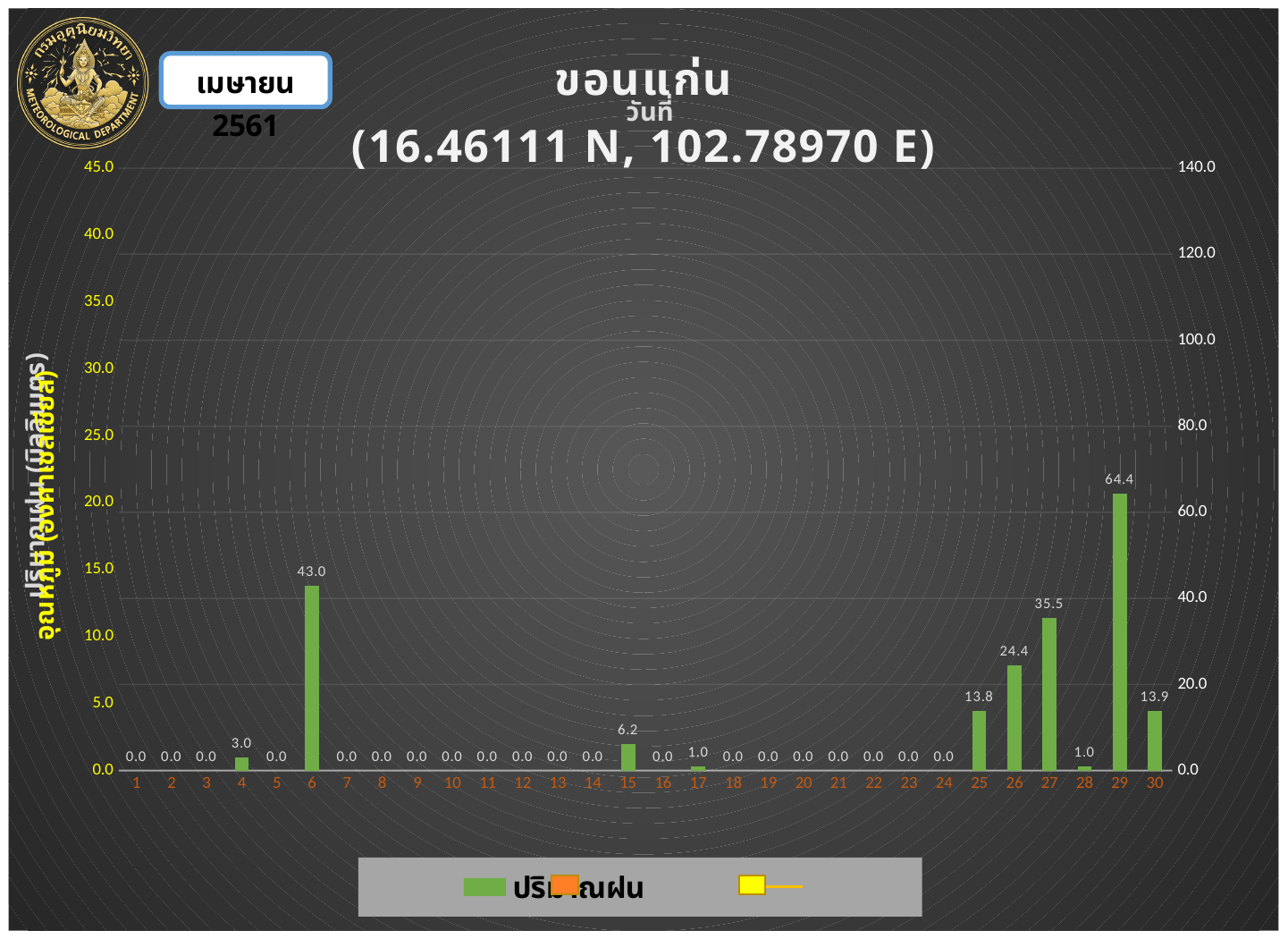
Which has a larger rainfall value, day 25 or day 30? day 30 What is the rainfall value shown for day 6? 43.0 What is the rainfall value shown for day 15? 6.2 What coordinates are given in the chart title? 16.46111 N, 102.78970 E What kind of chart is shown on the slide? bar chart What is the rainfall value shown for day 29? 64.4 What is the difference between the rainfall values for day 29 and day 6? 21.4 How many days are shown on the x axis? 30 What is the difference between the rainfall values for day 27 and day 26? 11.1 What is the rainfall value shown for day 27? 35.5 Which day has the highest rainfall value? 29 Is the value for day 29 greater or less than 60.0 on the right axis? greater